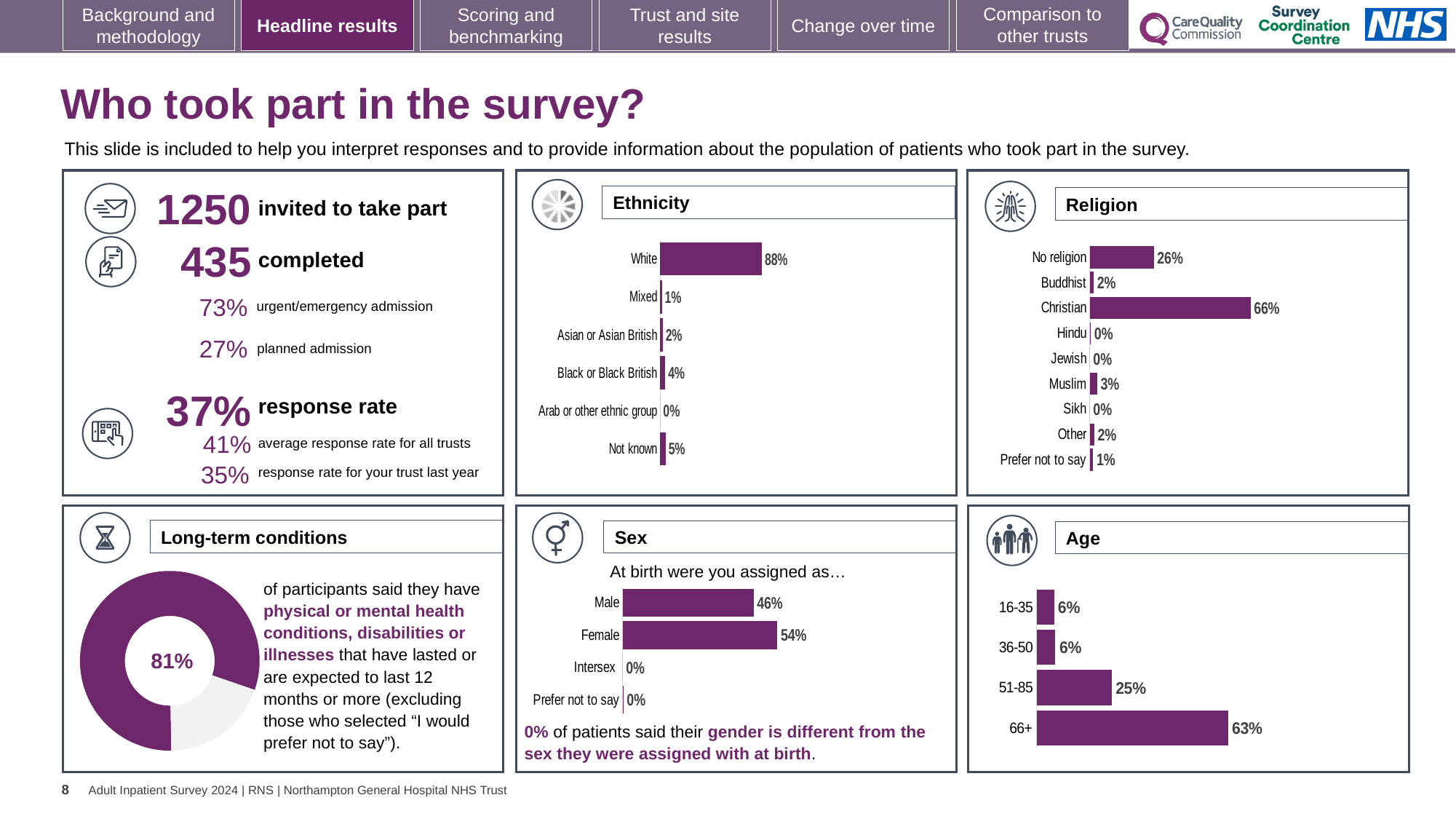
In the Sex chart, what is the difference between the Female and Male percentages? 8% In the Religion chart, what is the value for No religion? 26% In the Ethnicity chart, how many categories are shown? 6 In the Ethnicity chart, what percentage of respondents were White? 88% In the Long-term conditions chart, what share of participants said they have long-term conditions? 81% In the Age chart, which age group has the highest value? 66+ In the Sex chart, which is larger, Male or Female? Female In the Religion chart, how many categories are shown? 9 In the Ethnicity chart, what is the difference between the White and Not known values? 83% In the Religion chart, which category has the highest value? Christian In the Age chart, what is the value for 51-85? 25% What kind of chart is the Long-term conditions chart? Doughnut chart